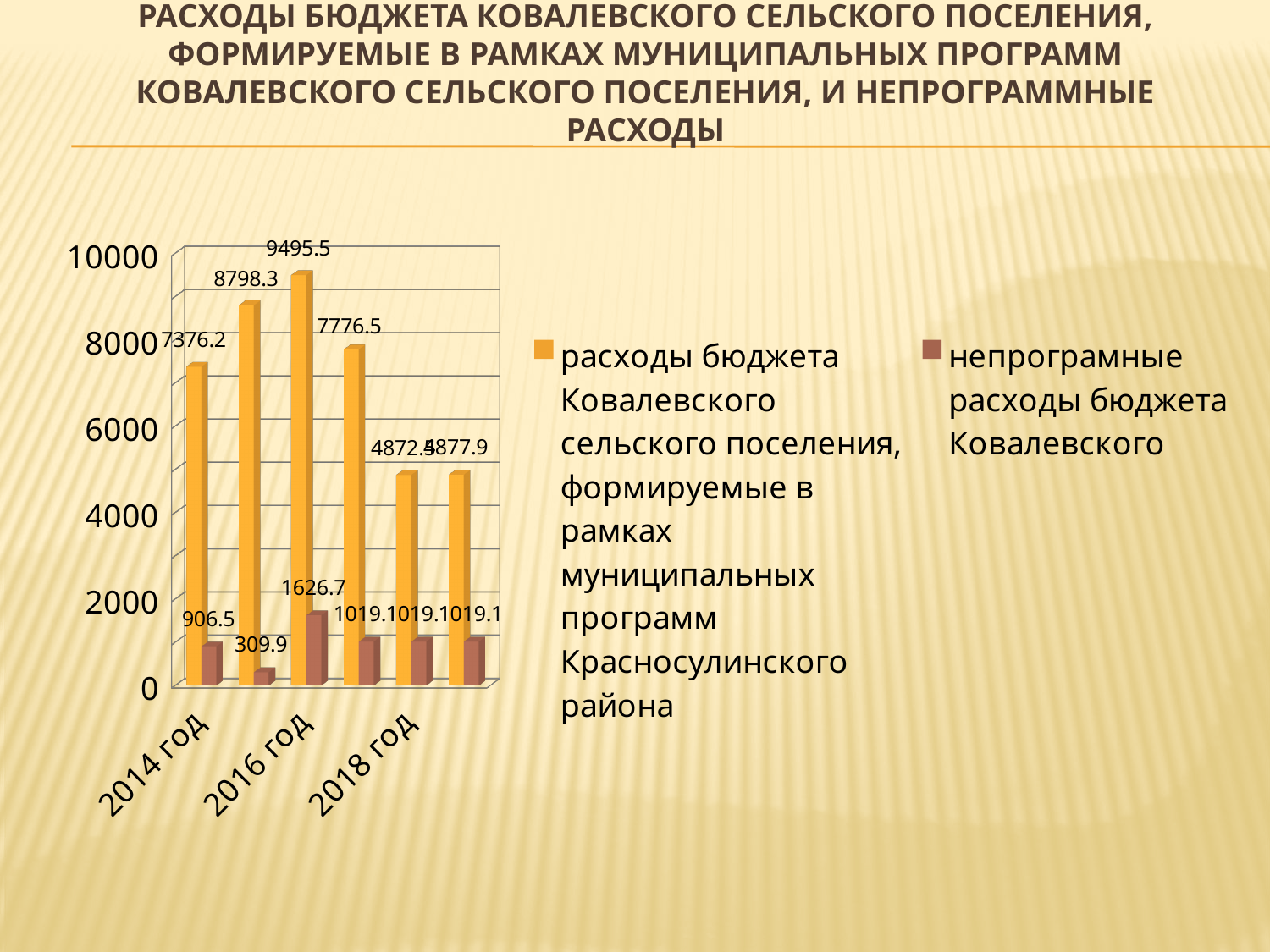
By how much do the program expenses in 2016 год exceed those in 2014 год? 2119.3 In which year are the non-program expenses the highest? 2016 год What is the value of the non-program expenses for 2018 год? 1019.1 Which year has larger program expenses, 2014 год or 2018 год? 2014 год In which year are the budget expenses formed within municipal programs the highest? 2016 год What kind of chart is shown on the slide? bar chart How many series does the legend list? 2 Is the value of the program expenses for 2018 год greater or less than 6000? less What is the value of the non-program expenses (непрограмные расходы бюджета) for 2014 год? 906.5 What is the value of the budget expenses formed within municipal programs for 2016 год? 9495.5 What is the value of the budget expenses formed within municipal programs (расходы бюджета ... формируемые в рамках муниципальных программ) for 2014 год? 7376.2 What is the value of the non-program expenses for 2016 год? 1626.7